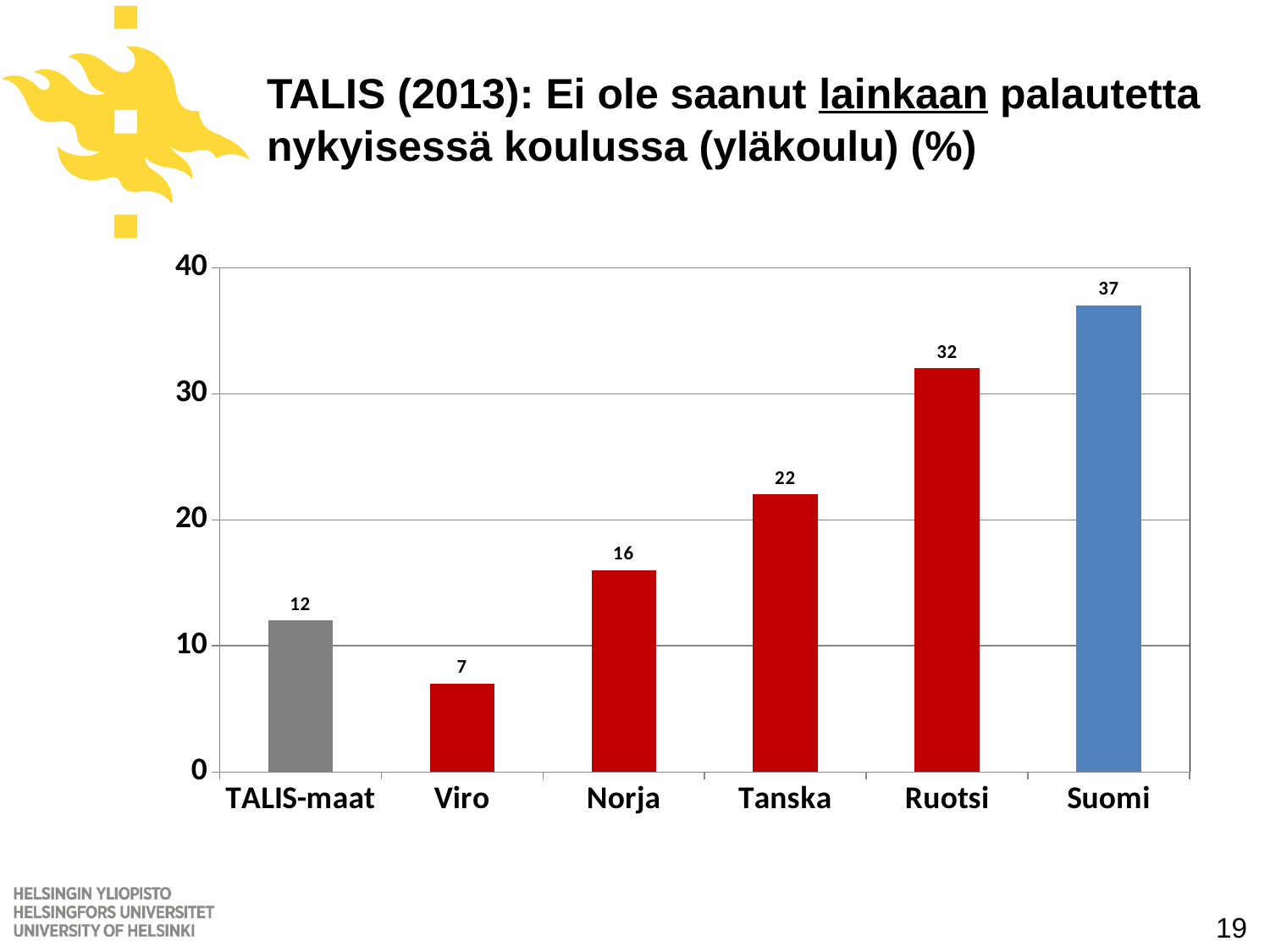
How many categories are shown on the x axis? 6 What is the value for TALIS-maat? 12 What is the value for Tanska? 22 What is the difference between the values for Suomi and Ruotsi? 5 Which bar is coloured blue? Suomi What kind of chart is shown on the slide? Bar chart What is the value for Viro? 7 Which category has the lowest value? Viro Which category has the highest value? Suomi What is the difference between the values for Norja and Viro? 9 Which is larger, the value for Tanska or the value for Norja? Tanska What is the value for Suomi? 37